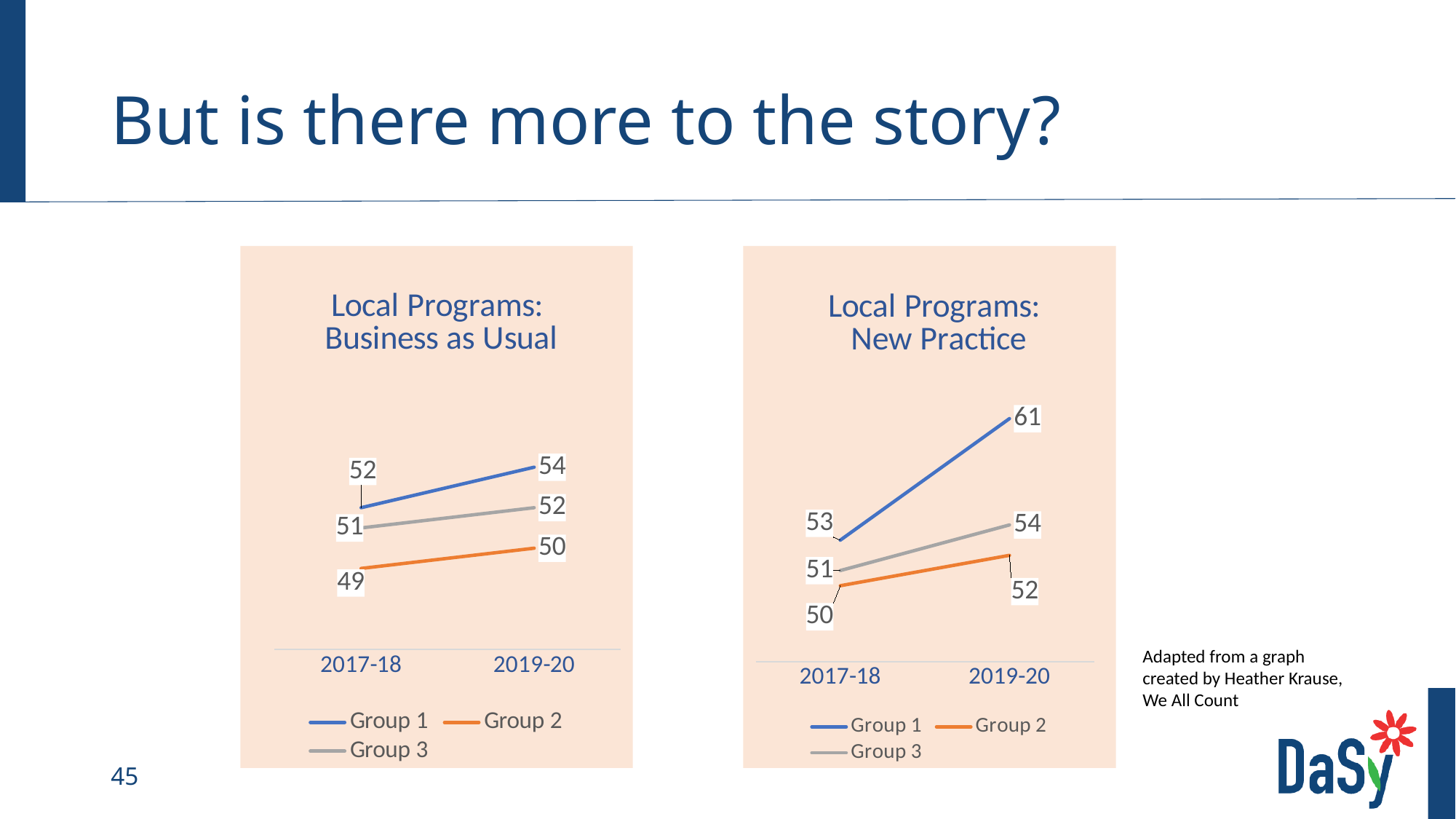
In the 'Local Programs: Business as Usual' chart, what is the value for Group 1 in 2019-20? 54 What kind of chart is the 'Local Programs: Business as Usual' chart? Line chart In the 'Local Programs: Business as Usual' chart, what is the value for Group 2 in 2017-18? 49 In the 'Local Programs: New Practice' chart, what is the value for Group 1 in 2019-20? 61 In the 'Local Programs: New Practice' chart, which group has the highest value in 2019-20? Group 1 In the 'Local Programs: New Practice' chart, what is the difference between Group 1's values in 2019-20 and 2017-18? 8 In the 'Local Programs: Business as Usual' chart, what is the difference between Group 1 and Group 2 in 2019-20? 4 In the 'Local Programs: New Practice' chart, does Group 2 rise or fall from 2017-18 to 2019-20? Rise Which is larger: Group 3 in 2019-20 in the 'Business as Usual' chart or Group 3 in 2019-20 in the 'New Practice' chart? New Practice In the 'Local Programs: New Practice' chart, what is the value for Group 3 in 2017-18? 51 How many series does the legend of the 'Local Programs: New Practice' chart list? 3 In the 'Local Programs: Business as Usual' chart, which group has the lowest value in 2017-18? Group 2